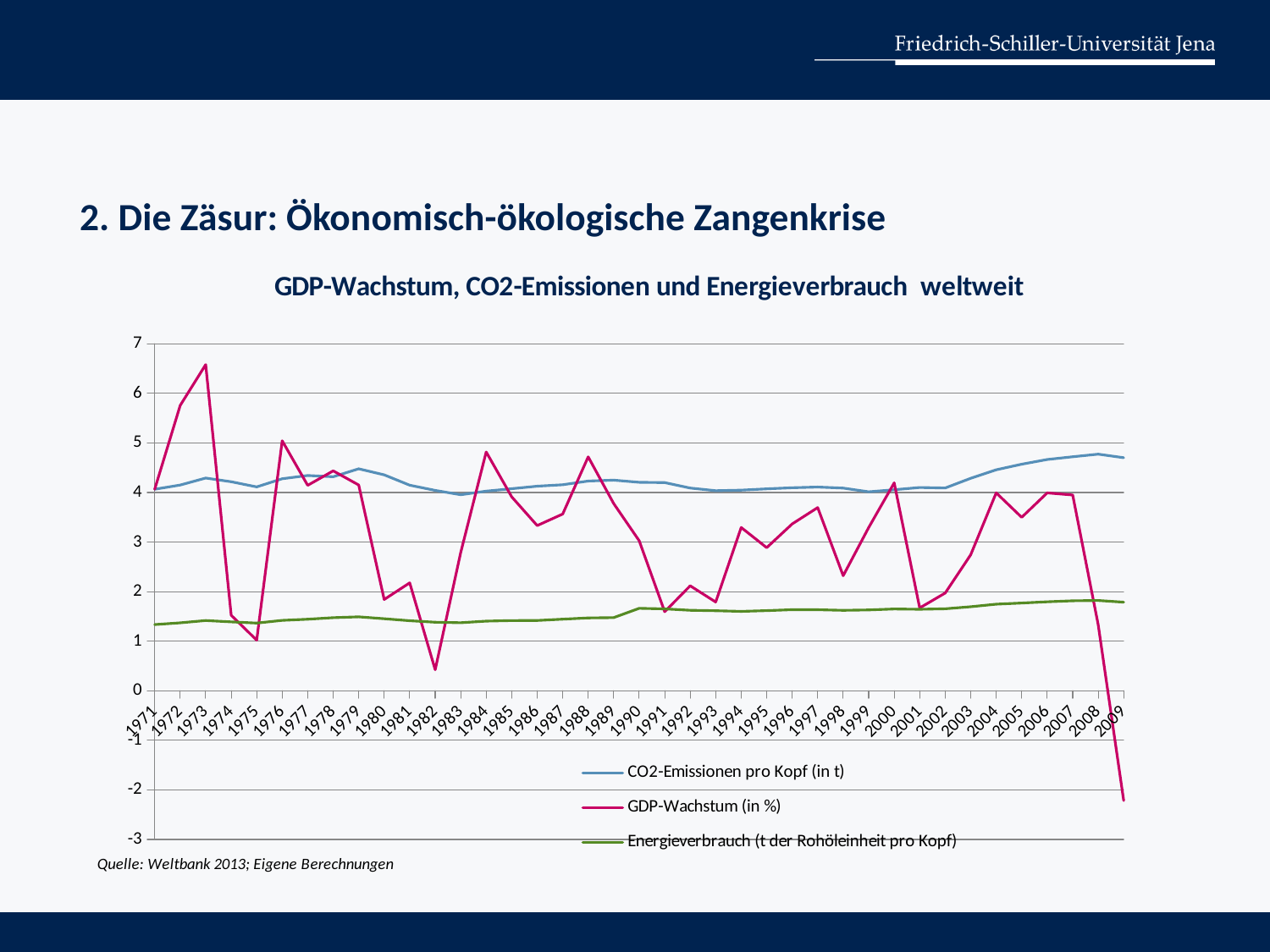
Is the value for Energieverbrauch (t der Rohöleinheit pro Kopf) in 1971 greater or less than 2? less Is the value for CO2-Emissionen pro Kopf (in t) in 2008 greater or less than 4? greater How many years are plotted along the x axis? 39 How many series does the legend list? 3 Is the value for GDP-Wachstum (in %) in 1973 greater or less than 6? greater In which year does GDP-Wachstum (in %) reach its highest value? 1973 What kind of chart is shown on the slide? line chart Does the Energieverbrauch (t der Rohöleinheit pro Kopf) line rise or fall overall from 1971 to 2009? rise In 2000, which is larger: CO2-Emissionen pro Kopf (in t) or Energieverbrauch (t der Rohöleinheit pro Kopf)? CO2-Emissionen pro Kopf (in t) What is the title of the chart? GDP-Wachstum, CO2-Emissionen und Energieverbrauch weltweit In which year does GDP-Wachstum (in %) reach its lowest value? 2009